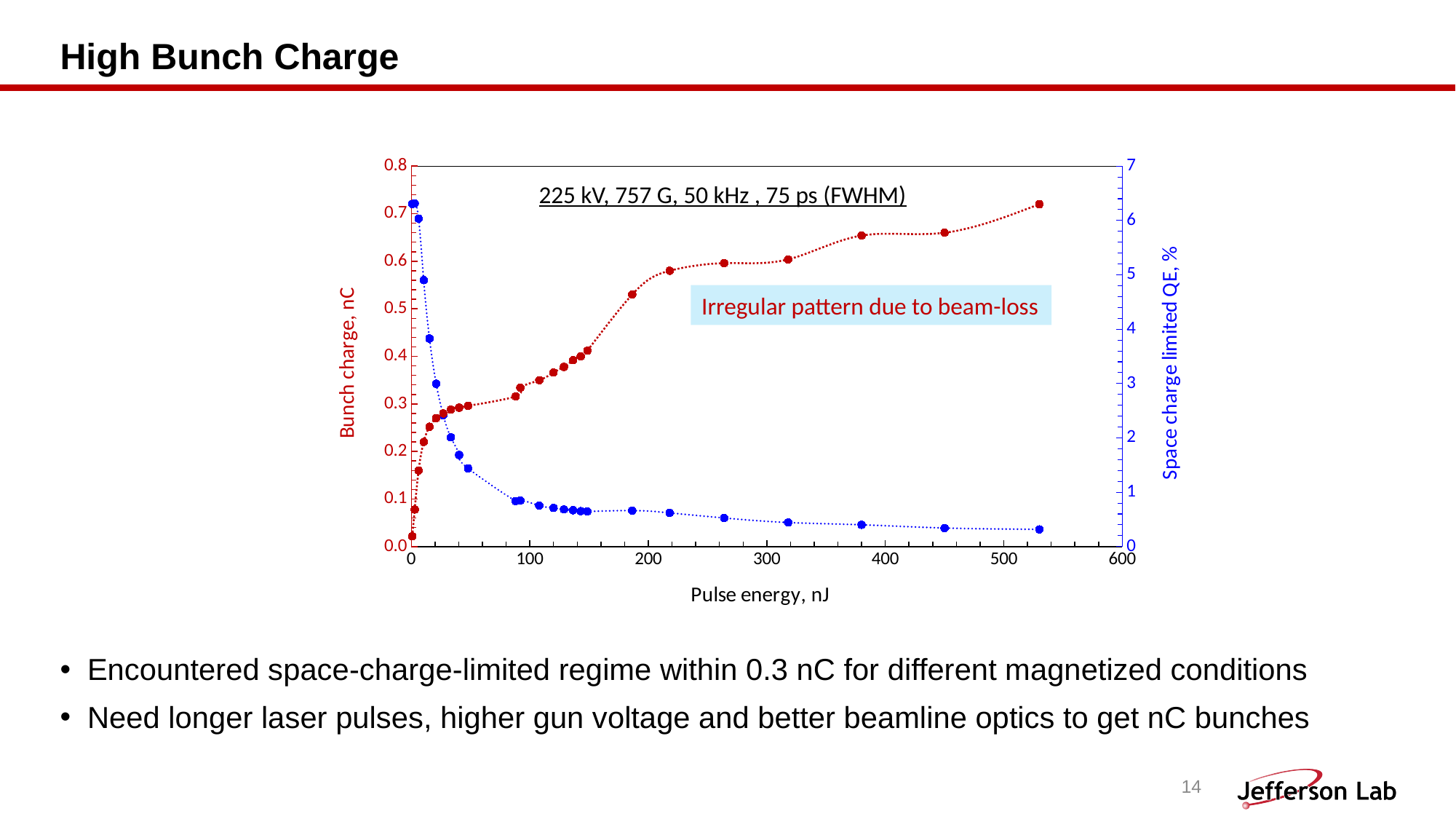
How many data series are plotted on the chart? 2 What kind of chart is shown on the slide? line chart Is the bunch charge at about 530 nJ pulse energy greater or less than 0.6 nC? greater Is the bunch charge at about 300 nJ pulse energy greater or less than 0.5 nC? greater Which is larger: the space charge limited QE at about 10 nJ or at about 100 nJ pulse energy? at about 10 nJ Is the space charge limited QE at about 500 nJ pulse energy greater or less than 1%? less What is the label of the x axis of the chart? Pulse energy, nJ What operating conditions are written in the underlined annotation at the top of the chart? 225 kV, 757 G, 50 kHz , 75 ps (FWHM) Does the bunch charge (red series) rise or fall as pulse energy increases? rise Does the space charge limited QE (blue series) rise or fall as pulse energy increases? fall Which is larger: the bunch charge at about 200 nJ or at about 100 nJ pulse energy? at about 200 nJ